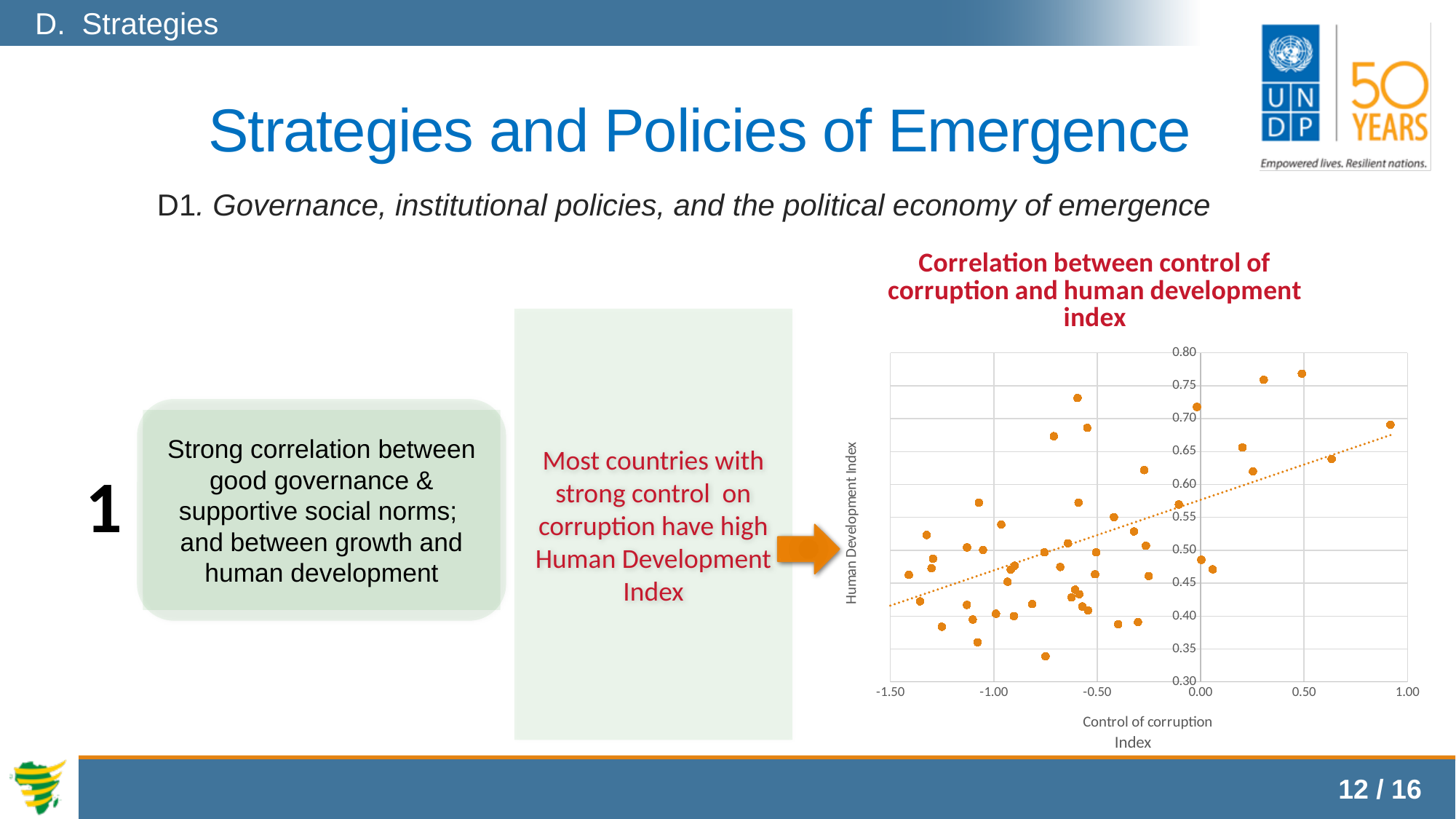
What is the label of the horizontal axis of the chart? Control of corruption Index What is the label of the vertical axis of the chart? Human Development Index Does the dotted trend line in the chart rise or fall as the Control of corruption Index increases? rise What is the lowest value shown on the horizontal axis of the chart? -1.50 What is the title of the chart? Correlation between control of corruption and human development index What is the highest value shown on the vertical axis of the chart? 0.80 Is the Human Development Index of the lowest point in the chart greater or less than 0.35? less What is the lowest value shown on the vertical axis of the chart? 0.30 What is the highest value shown on the horizontal axis of the chart? 1.00 What kind of chart is shown on the slide? scatter chart Is the Human Development Index of the highest point in the chart greater or less than 0.75? greater What colour are the data points in the chart? orange